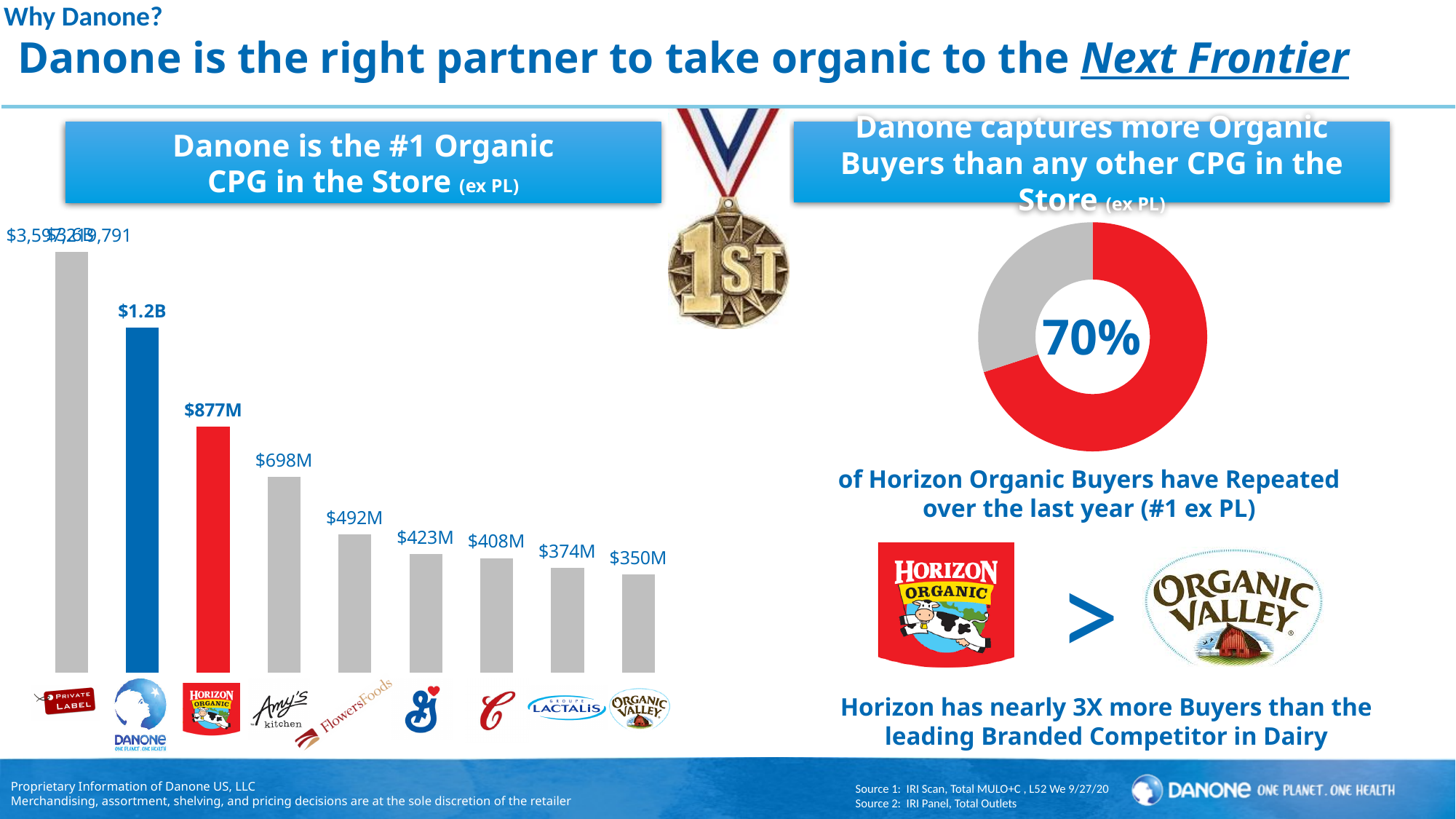
In the bar chart on the left, what is the value shown for Danone? $1.2B In the bar chart on the left, what is the difference between the Horizon Organic value and the Amy's Kitchen value? $179M In the bar chart on the left, which category has the tallest bar? Private Label In the bar chart on the left, which is larger, the value for Lactalis or the value for Organic Valley? Lactalis In the donut chart on the right, what percentage is shown for the red segment? 70% In the bar chart on the left, what is the value shown for Amy's Kitchen? $698M Do the values in the bar chart on the left rise or fall from left to right? fall In the bar chart on the left, what is the value shown for Horizon Organic? $877M How many bars are in the bar chart on the left? 9 In the bar chart on the left, what is the value shown for Organic Valley? $350M In the bar chart on the left, which category has the lowest value? Organic Valley In the bar chart on the left, what is the value shown for Lactalis? $374M